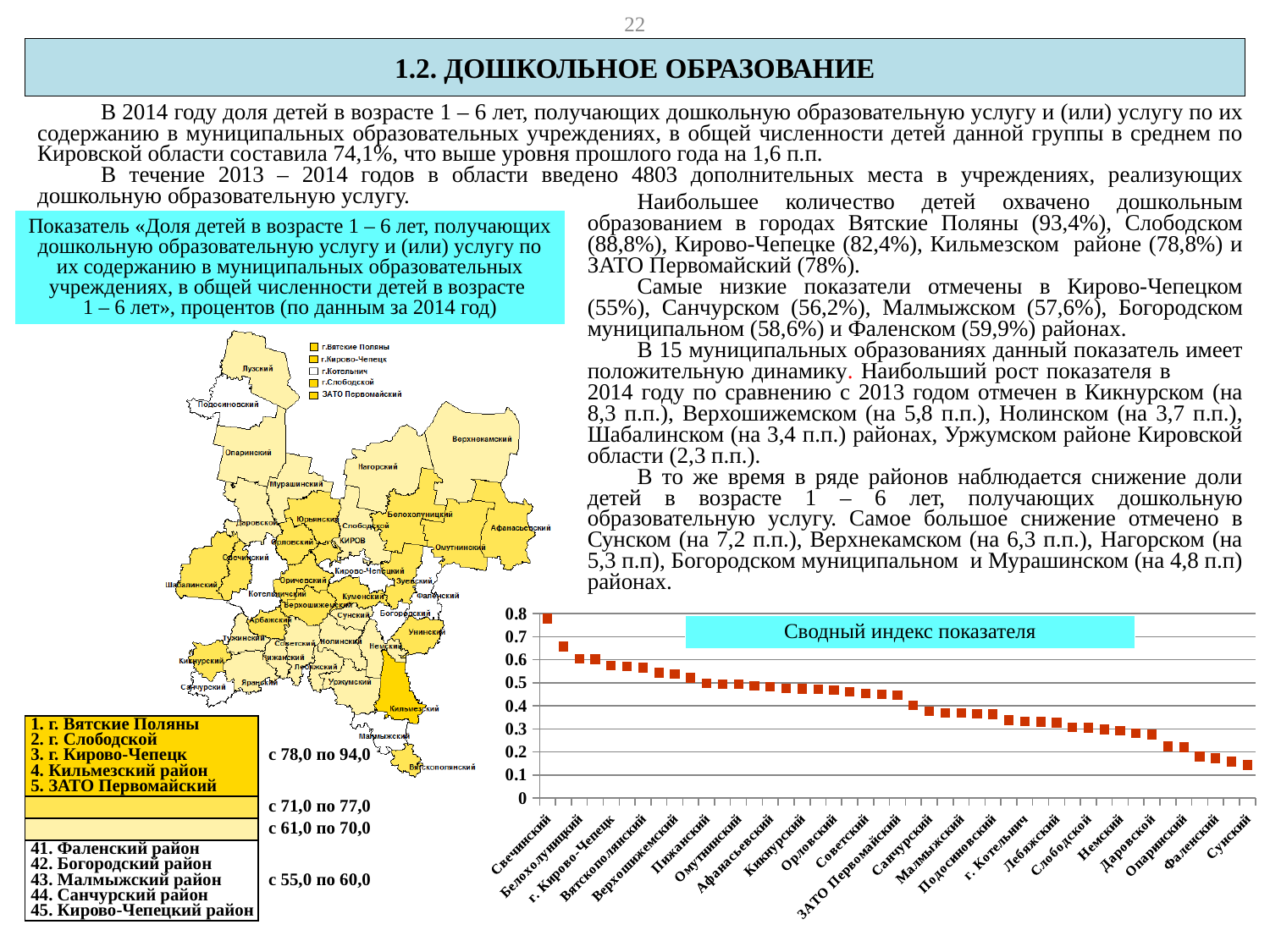
What is the title of the chart at the bottom right of the slide? Сводный индекс показателя In the chart 'Сводный индекс показателя', is the value for Орловский greater or less than 0.5? less What is the highest value shown on the y axis of the chart 'Сводный индекс показателя'? 0.8 In the chart 'Сводный индекс показателя', is the value for Свечинский greater or less than 0.7? greater In the chart 'Сводный индекс показателя', is the value for Подосиновский greater or less than 0.4? less In the chart 'Сводный индекс показателя', do the values rise or fall from left to right along the x axis? fall In the chart 'Сводный индекс показателя', which category has the lowest value? Сунский In the chart 'Сводный индекс показателя', which category has the highest value? Свечинский In the chart 'Сводный индекс показателя', which is larger, the value for Белохолуницкий or the value for Опаринский? Белохолуницкий